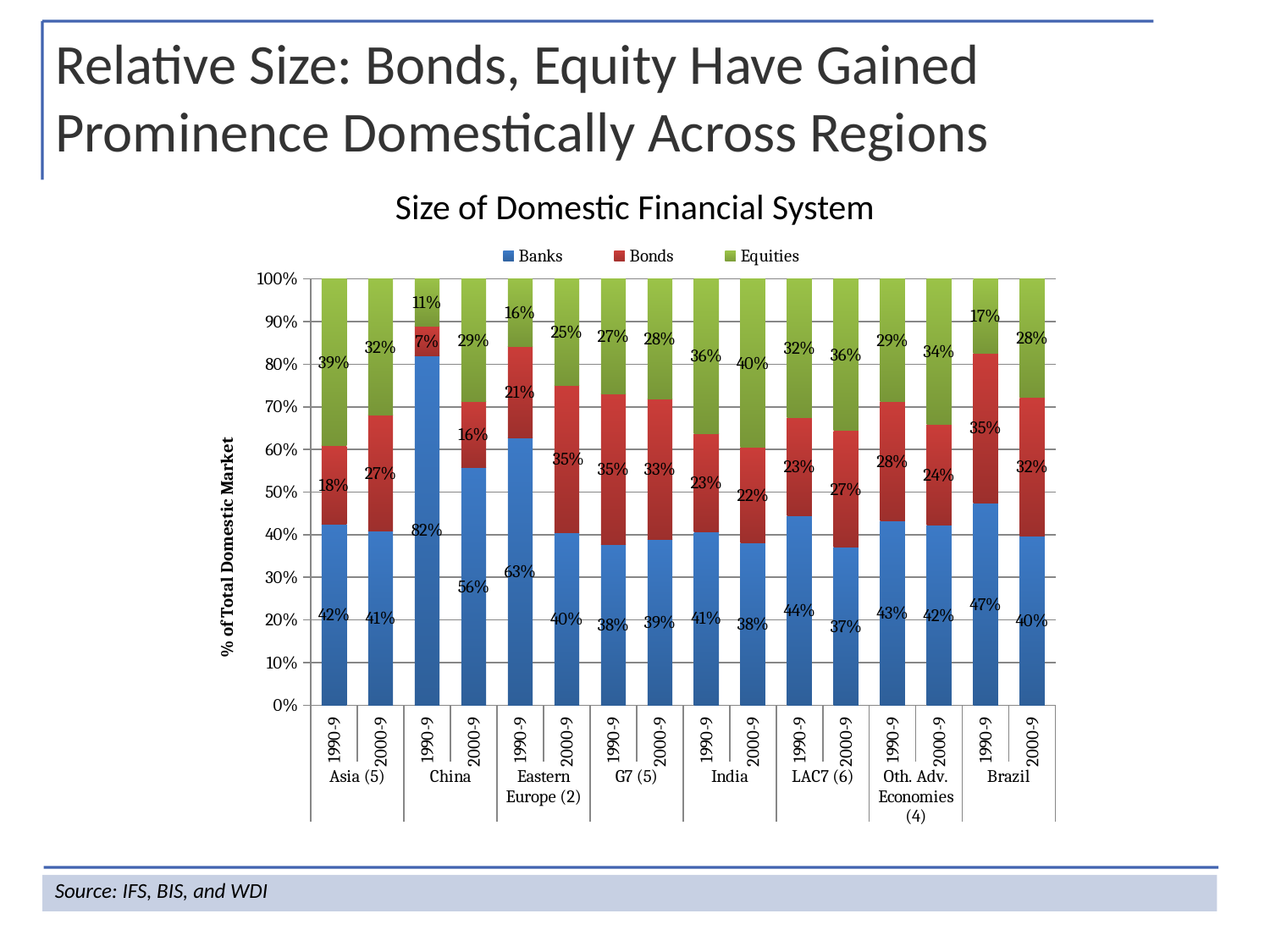
How many bars are plotted in the chart? 16 What is the Bonds share for Brazil in 1990-9? 35% What type of chart is shown on the slide? stacked bar chart Which is larger, the Bonds share for Asia (5) in 1990-9 or in 2000-9? 2000-9 Which bar has the lowest Equities share? China 1990-9 What is the Banks share for China in 1990-9? 82% What is the title of the chart? Size of Domestic Financial System What is the difference between the Banks share for China in 1990-9 and in 2000-9? 26% Which bar has the highest Banks share? China 1990-9 What is the Equities share for India in 2000-9? 40% What is the label of the vertical axis? % of Total Domestic Market How many series does the legend list? 3